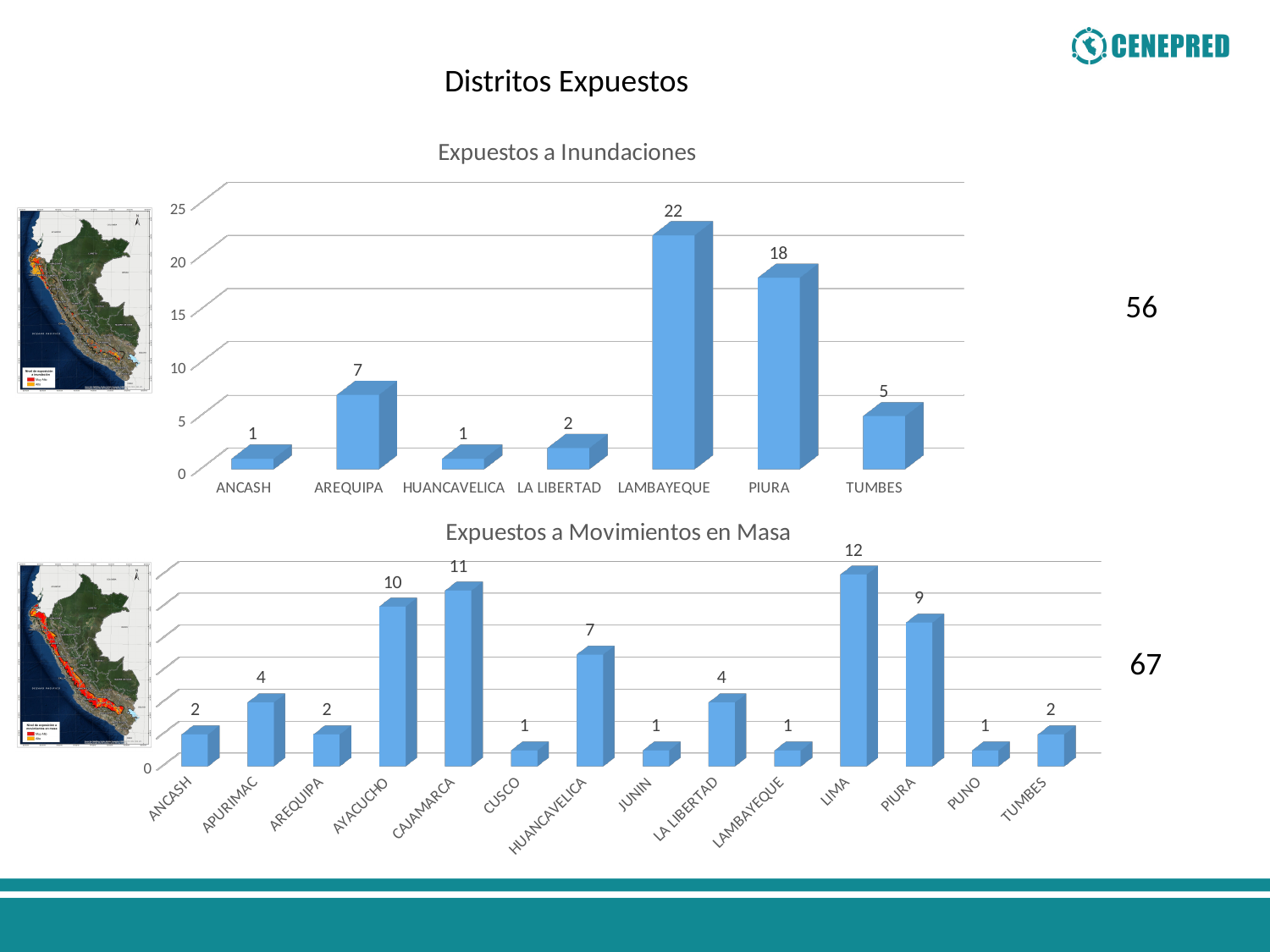
In the 'Expuestos a Inundaciones' chart, how many categories are shown on the x axis? 7 In the 'Expuestos a Movimientos en Masa' chart, what is the value for LIMA? 12 What kind of chart is 'Expuestos a Inundaciones'? Bar chart In the 'Expuestos a Movimientos en Masa' chart, what is the difference between HUANCAVELICA and LA LIBERTAD? 3 What is the title of the top chart on the slide? Expuestos a Inundaciones In the 'Expuestos a Movimientos en Masa' chart, how many categories are shown on the x axis? 14 In the 'Expuestos a Movimientos en Masa' chart, which category has the highest value? LIMA In the 'Expuestos a Inundaciones' chart, what is the value for LAMBAYEQUE? 22 In the 'Expuestos a Inundaciones' chart, which category has the highest value? LAMBAYEQUE In the 'Expuestos a Movimientos en Masa' chart, which is larger, AYACUCHO or CAJAMARCA? CAJAMARCA In the 'Expuestos a Inundaciones' chart, is the value for AREQUIPA greater or less than 5? greater In the 'Expuestos a Inundaciones' chart, what is the difference between PIURA and TUMBES? 13